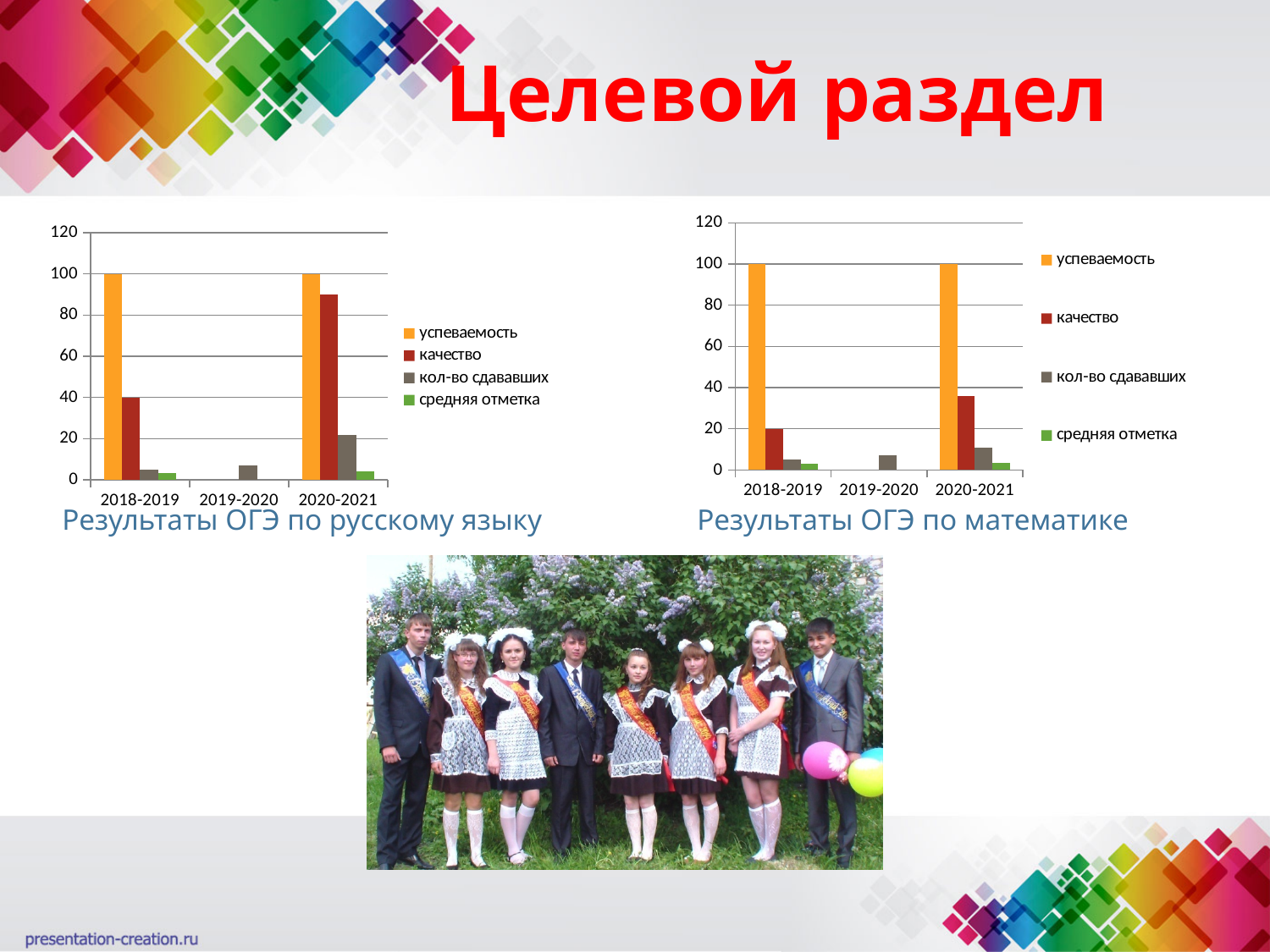
In the 'Результаты ОГЭ по математике' chart, does the value of качество rise or fall from 2018-2019 to 2020-2021? rise How many series does the legend of the 'Результаты ОГЭ по математике' chart list? 4 In the 'Результаты ОГЭ по математике' chart, is the value of качество for 2020-2021 greater or less than 40? less In the 'Результаты ОГЭ по русскому языку' chart, is the value of качество for 2020-2021 greater or less than 80? greater In the 'Результаты ОГЭ по русскому языку' chart, what is the value of успеваемость for 2018-2019? 100 What kind of chart is the 'Результаты ОГЭ по русскому языку' chart? bar chart In the 'Результаты ОГЭ по русскому языку' chart, which series has the highest value for 2020-2021? успеваемость How many categories are shown on the x axis of the 'Результаты ОГЭ по русскому языку' chart? 3 In the 'Результаты ОГЭ по русскому языку' chart, is качество larger in 2018-2019 or in 2020-2021? 2020-2021 In the 'Результаты ОГЭ по математике' chart, what is the value of успеваемость for 2020-2021? 100 What colour represents the series 'кол-во сдававших' in the 'Результаты ОГЭ по математике' chart? grey In the 'Результаты ОГЭ по математике' chart, which series has the lowest value for 2018-2019? средняя отметка